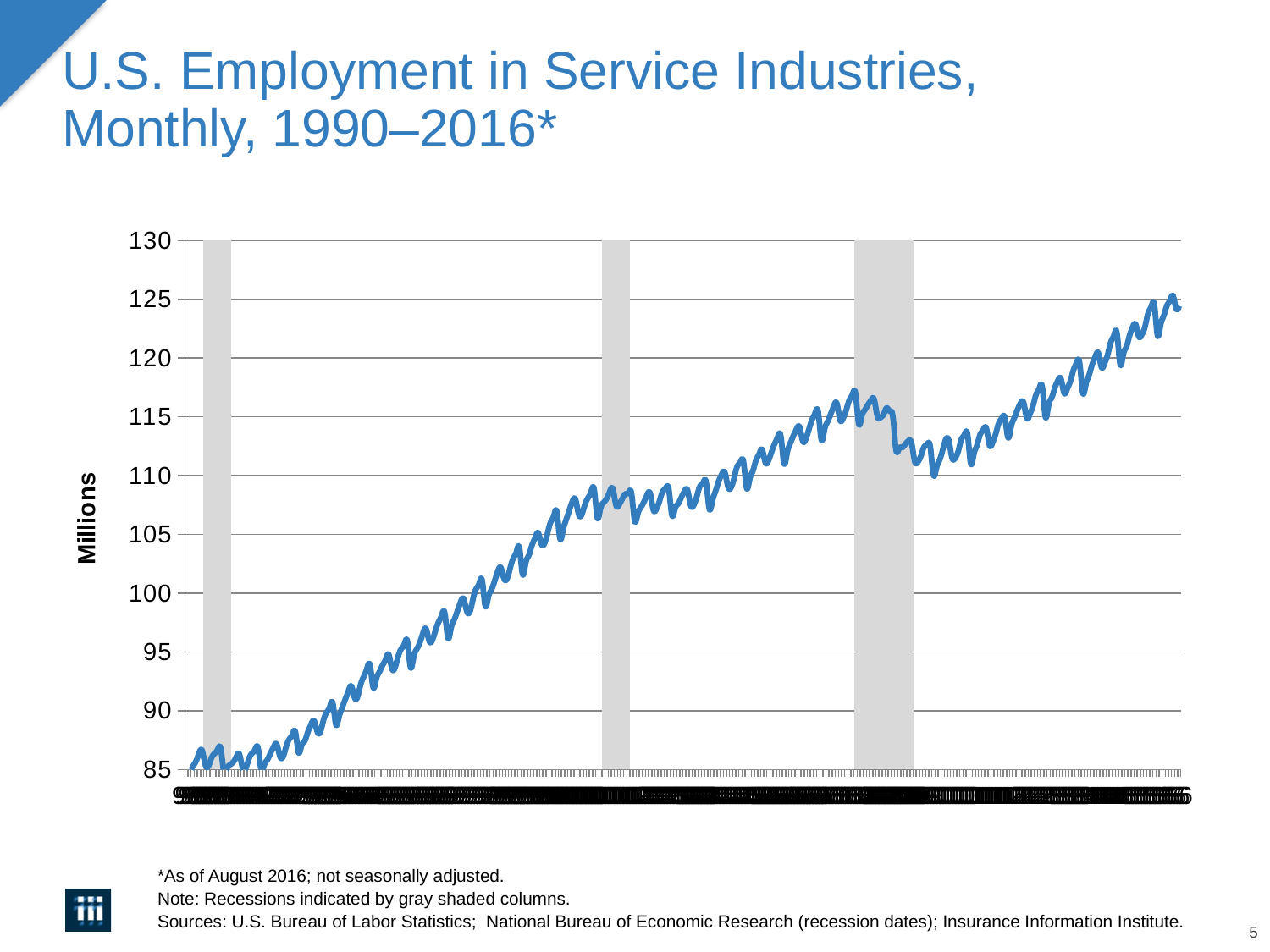
Is the value at the end of the third gray shaded column greater or less than 115? less What is the highest value shown on the vertical axis? 130 Is the value at the start of the third gray shaded column greater or less than 115? greater What is the title of the chart? U.S. Employment in Service Industries, Monthly, 1990–2016* Overall, do the values rise or fall from left to right along the x axis? Rise What kind of chart is shown on the slide? Line chart What is the lowest value shown on the vertical axis? 85 Is the value at the start of the series (1990) greater or less than 90? less